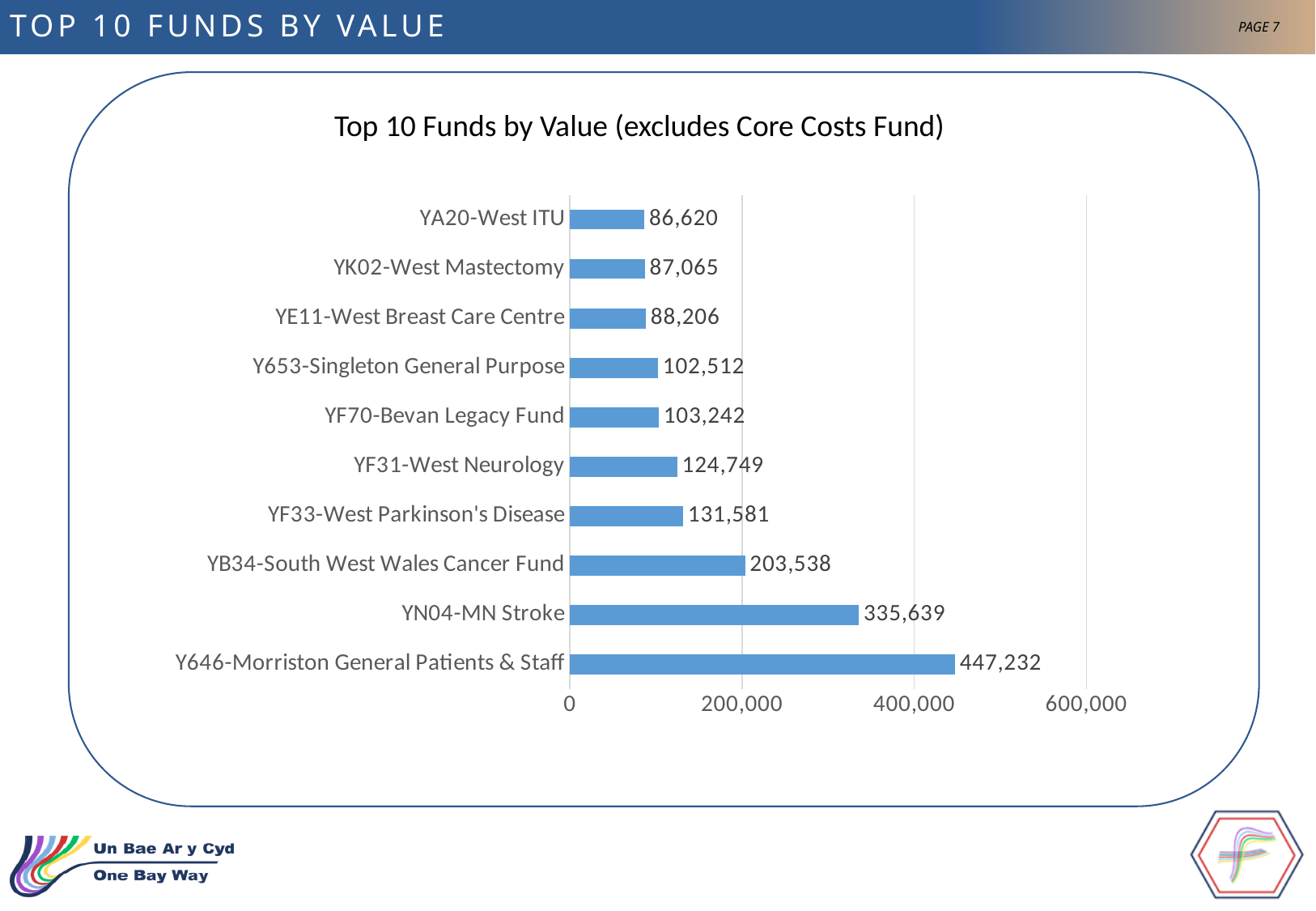
What is the difference between the values for YB34-South West Wales Cancer Fund and YF33-West Parkinson's Disease? 71,957 Which fund has the lowest value? YA20-West ITU What is the value for YF31-West Neurology? 124,749 What is the difference between the values for Y646-Morriston General Patients & Staff and YN04-MN Stroke? 111,593 What is the value for YE11-West Breast Care Centre? 88,206 What kind of chart is shown on the slide? bar chart Is the value for YB34-South West Wales Cancer Fund greater or less than 200,000? greater What is the title of the chart? Top 10 Funds by Value (excludes Core Costs Fund) How many funds are shown in the chart? 10 Which is larger, the value for YF70-Bevan Legacy Fund or the value for YF31-West Neurology? YF31-West Neurology What is the value for YN04-MN Stroke? 335,639 Which fund has the highest value? Y646-Morriston General Patients & Staff